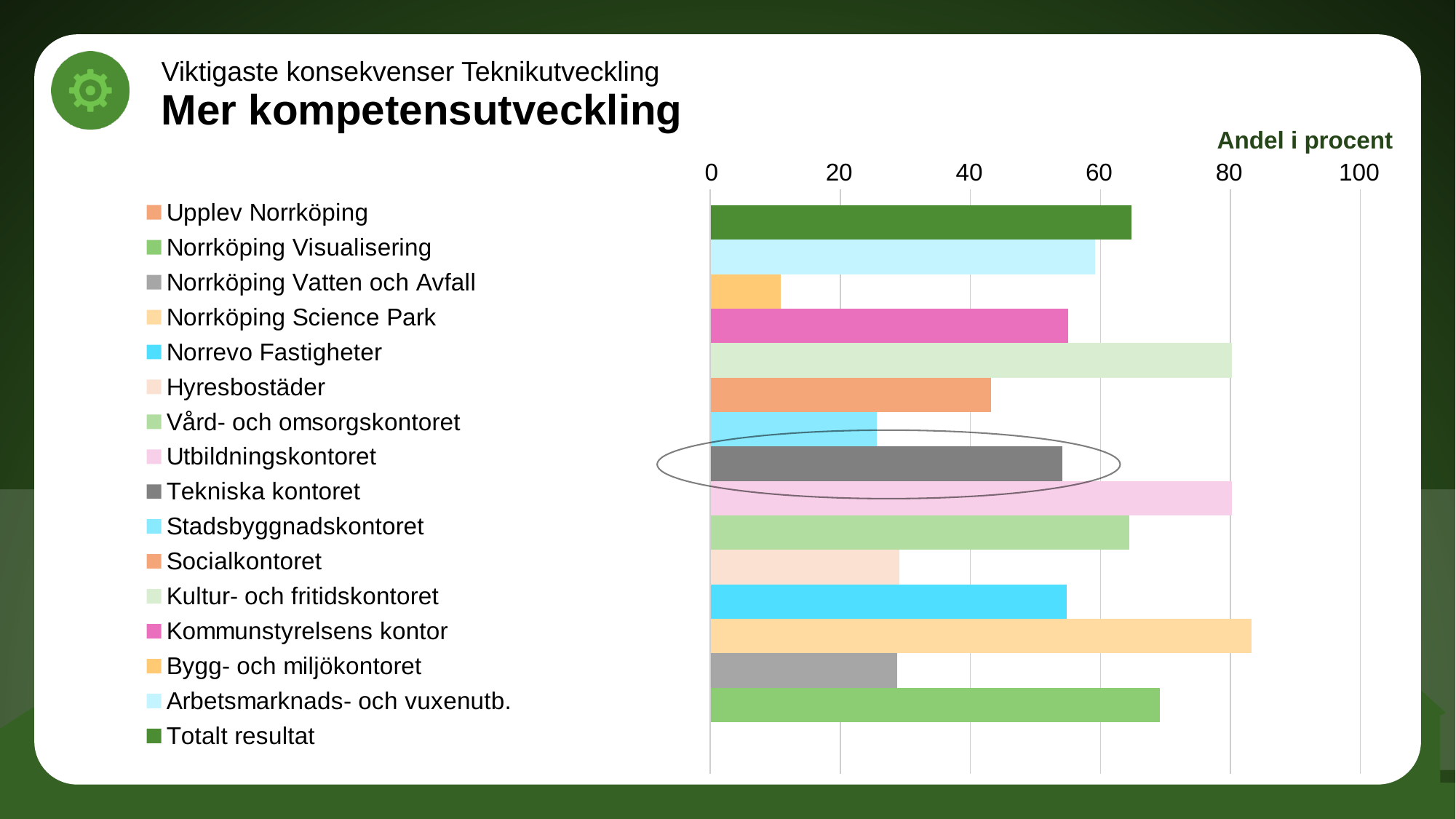
Is the value for Hyresbostäder greater or less than 40? less Which is larger, the value for Norrköping Visualisering or the value for Hyresbostäder? Norrköping Visualisering Is the value for Norrköping Science Park greater or less than 80? greater What kind of chart is shown on the slide? bar chart Is the value for Bygg- och miljökontoret greater or less than 20? less Which category's bar is circled on the chart? Tekniska kontoret Which is larger, the value for Totalt resultat or the value for Socialkontoret? Totalt resultat What is the title of the horizontal axis? Andel i procent How many categories does the legend list? 16